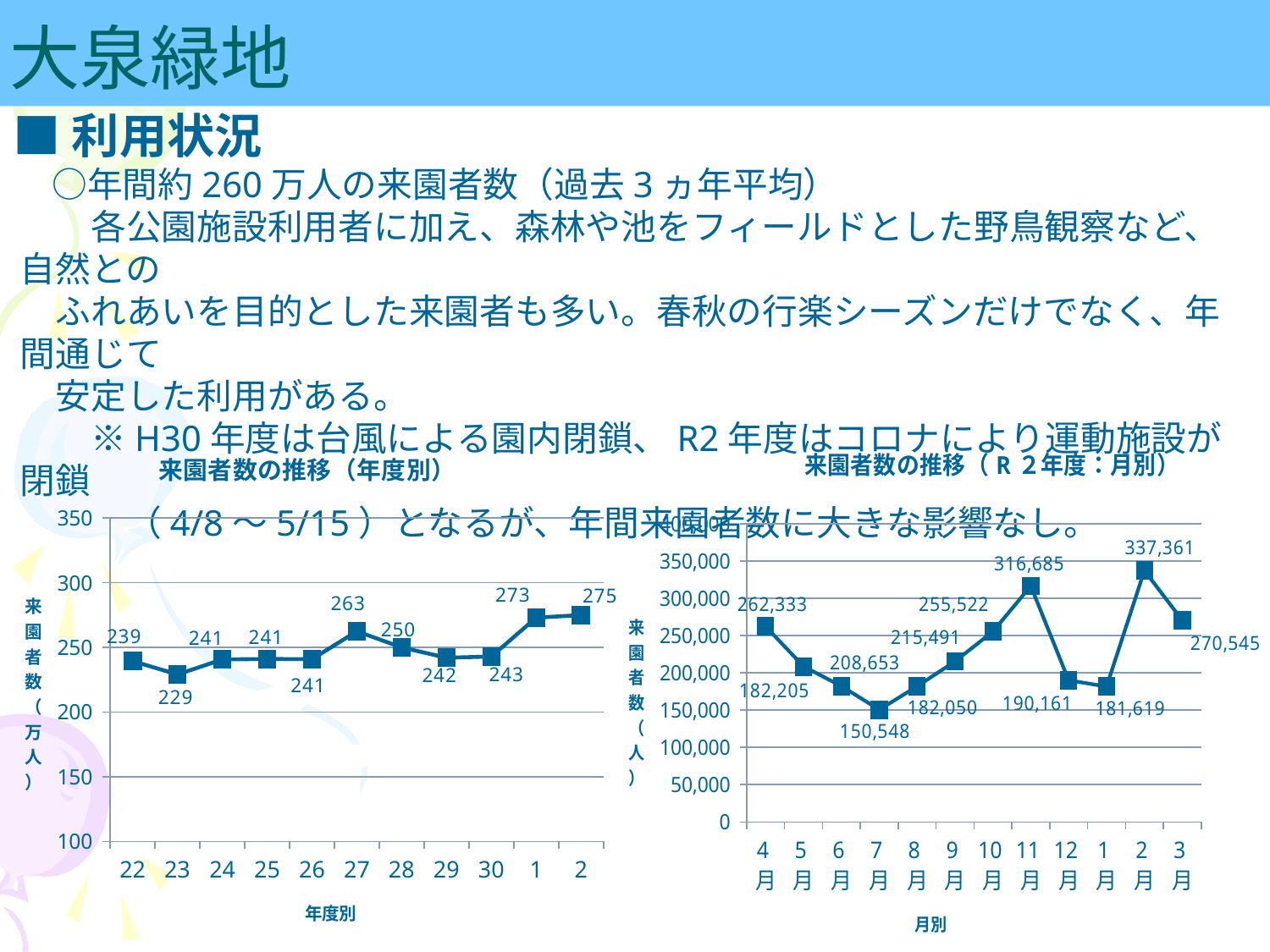
In the left chart (来園者数の推移（年度別）), what is the value for 年度 27? 263 In the right chart (来園者数の推移（R２年度：月別）), which month has the highest value? 2月 In the right chart (来園者数の推移（R２年度：月別）), what is the value for 11月? 316,685 In the left chart (来園者数の推移（年度別）), which 年度 has the highest value? 2 In the right chart (来園者数の推移（R２年度：月別）), which month has the lowest value? 7月 In the left chart (来園者数の推移（年度別）), what is the value for 年度 23? 229 What kind of chart is the left chart (来園者数の推移（年度別）)? line chart In the right chart (来園者数の推移（R２年度：月別）), what is the value for 7月? 150,548 In the left chart (来園者数の推移（年度別）), what is the difference between the values for 年度 2 and 年度 23? 46 In the left chart (来園者数の推移（年度別）), how many data points are plotted? 11 In the left chart (来園者数の推移（年度別）), which 年度 has the lowest value? 23 In the right chart (来園者数の推移（R２年度：月別）), which is larger, the value for 4月 or the value for 3月? 3月